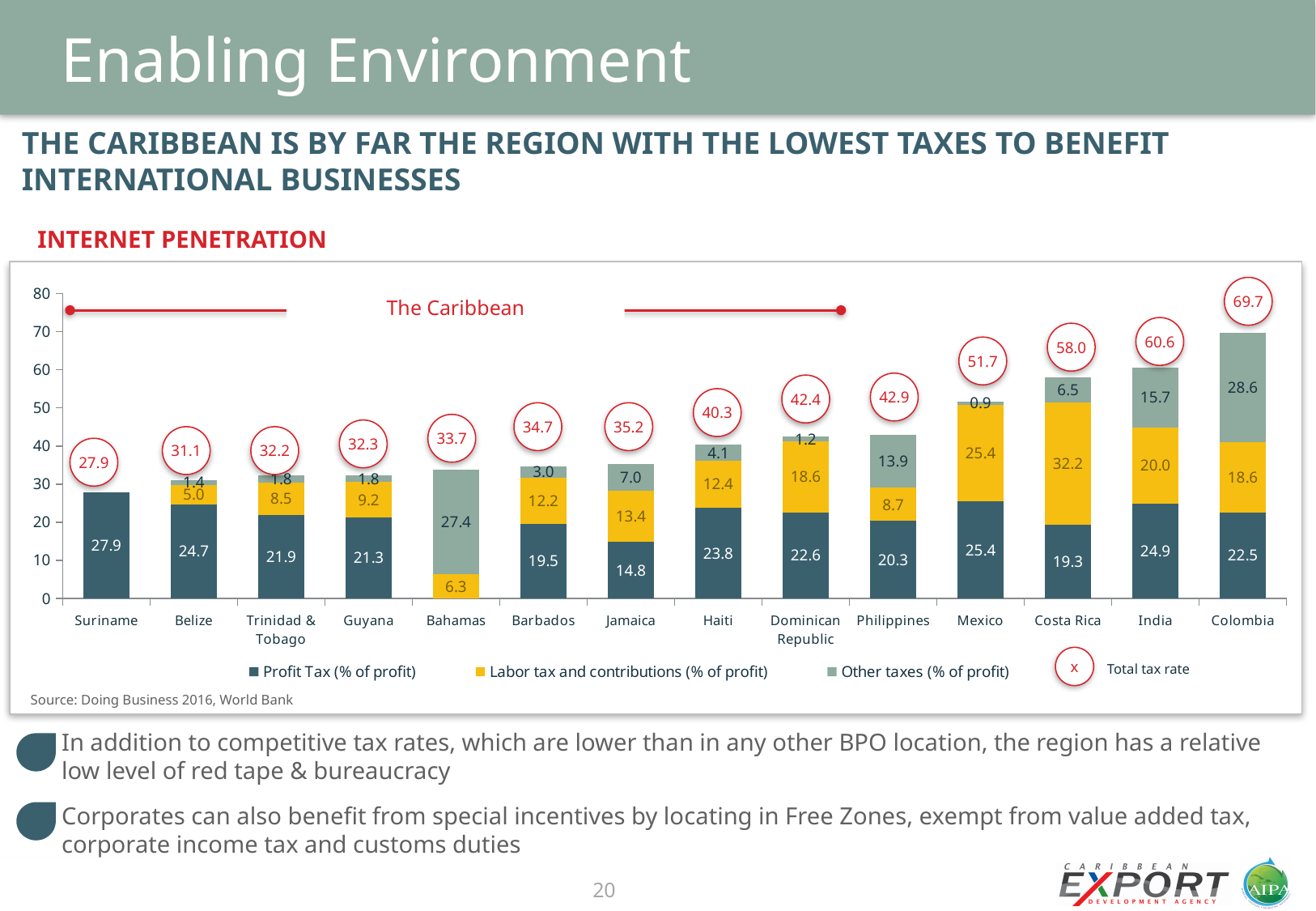
What is the total tax rate shown for Colombia? 69.7 What is the Labor tax and contributions (% of profit) value for Costa Rica? 32.2 What is the Profit Tax (% of profit) value for Haiti? 23.8 What is the difference between the total tax rates of India and Mexico? 8.9 What kind of chart is shown? Stacked bar chart How many countries are shown on the x axis? 14 How many series does the legend list for the stacked bars? 3 What is the Other taxes (% of profit) value for the Bahamas? 27.4 Which has a higher Profit Tax (% of profit): Jamaica or Barbados? Barbados Which country has the highest total tax rate? Colombia Which country has the lowest total tax rate? Suriname Do the total tax rates rise or fall moving from left to right along the x axis? Rise